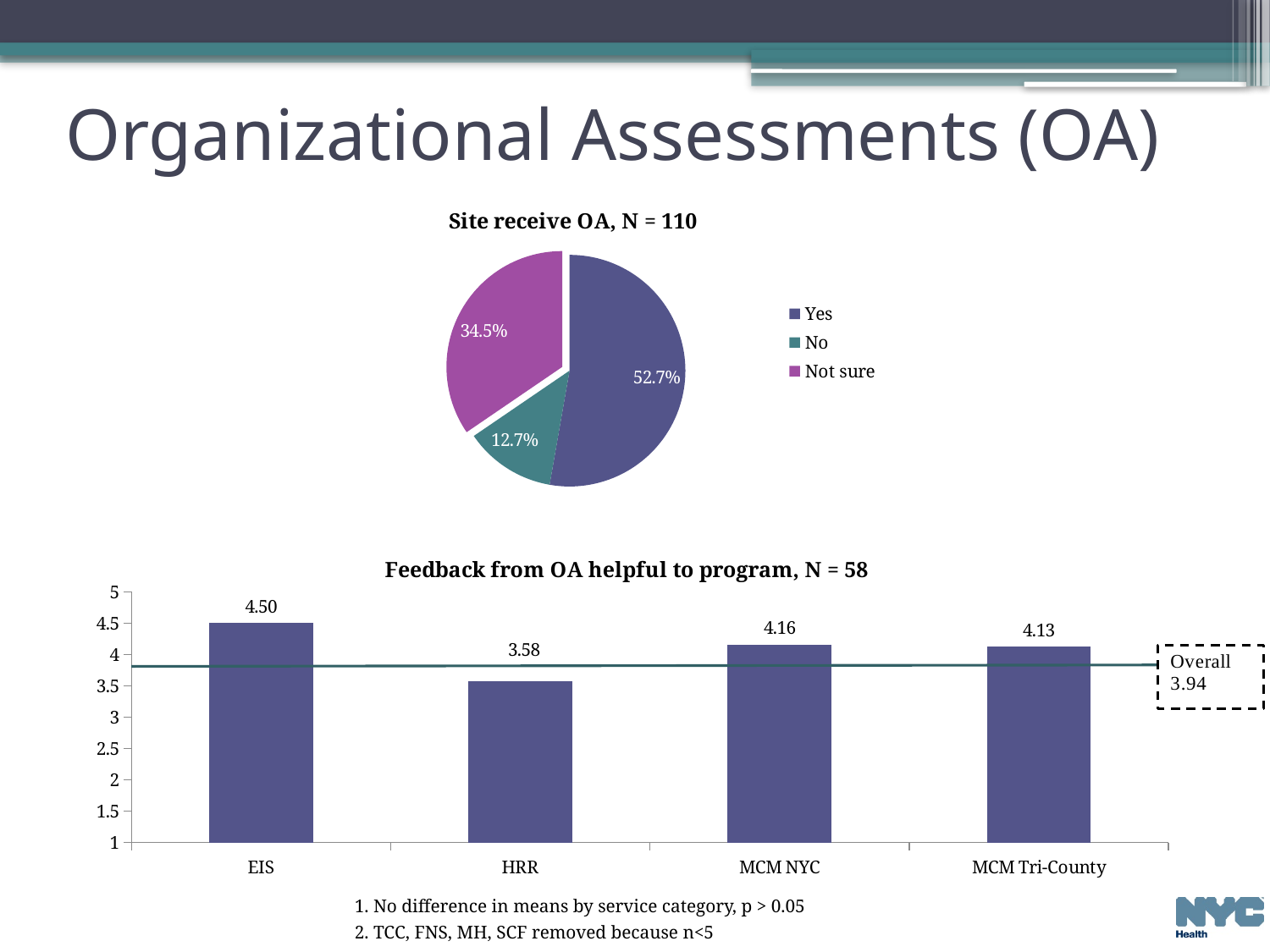
In the 'Feedback from OA helpful to program, N = 58' chart, how many categories are shown on the x axis? 4 What kind of chart is the 'Feedback from OA helpful to program, N = 58' chart? Bar chart In the 'Site receive OA, N = 110' pie chart, how many entries does the legend list? 3 In the 'Feedback from OA helpful to program, N = 58' chart, what is the overall value shown by the horizontal line? 3.94 In the 'Feedback from OA helpful to program, N = 58' chart, what is the value for MCM NYC? 4.16 In the 'Feedback from OA helpful to program, N = 58' chart, what is the value for HRR? 3.58 In the 'Site receive OA, N = 110' pie chart, what share of sites answered 'Not sure'? 34.5% In the 'Feedback from OA helpful to program, N = 58' chart, what is the difference between the values for EIS and HRR? 0.92 In the 'Feedback from OA helpful to program, N = 58' chart, which category has the highest value? EIS In the 'Site receive OA, N = 110' pie chart, which response has the smallest slice? No What kind of chart is the 'Site receive OA, N = 110' chart? Pie chart In the 'Site receive OA, N = 110' pie chart, what share of sites answered 'Yes'? 52.7%